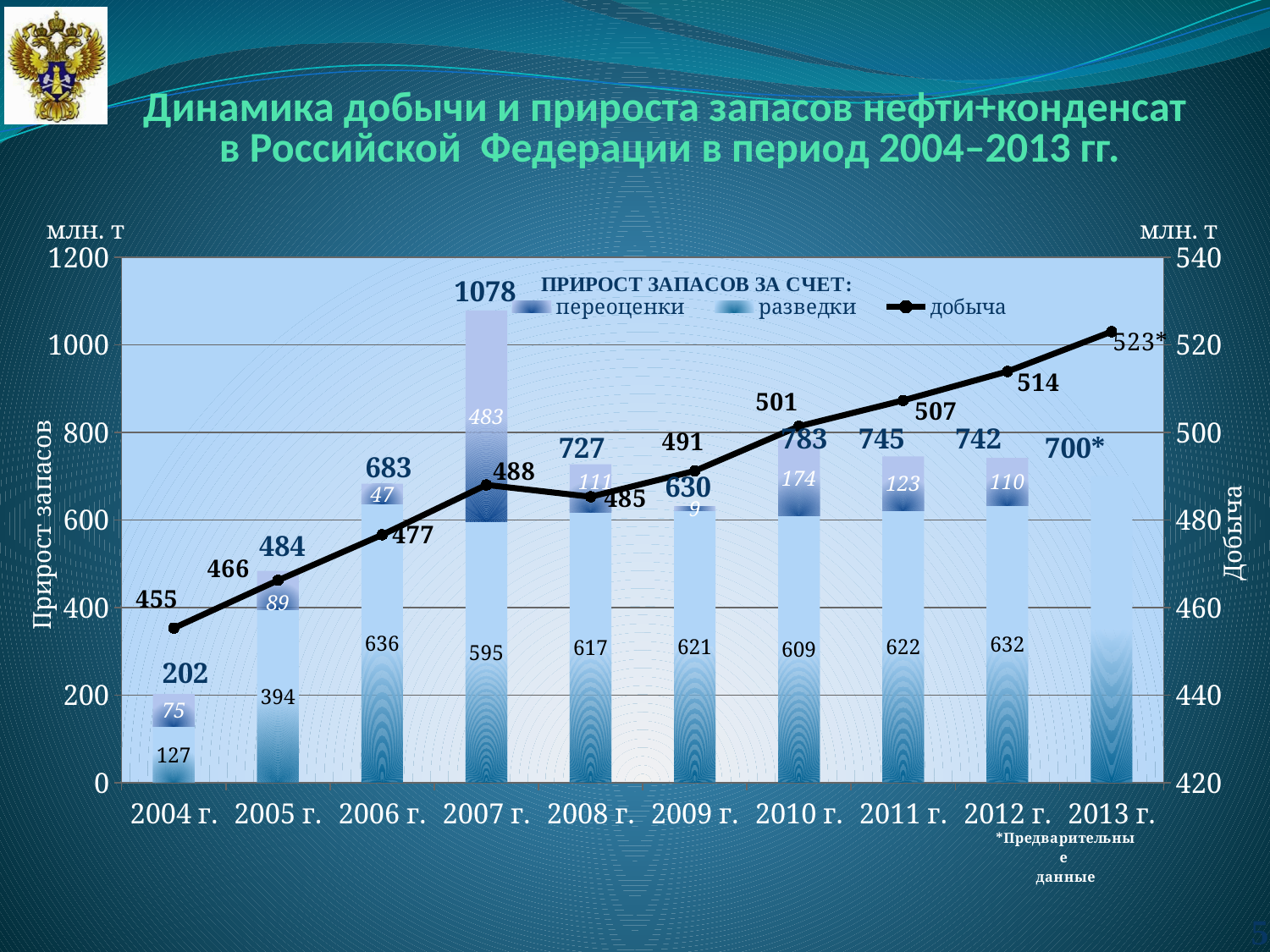
How many series does the chart legend list? 3 What is the разведки (exploration) component of the reserves growth bar for 2006 г.? 636 What kind of chart is shown on the slide? Combined stacked bar and line chart By how much did добыча (production) increase from 2004 г. (455) to 2013 г. (523*)? 68 In which year is the total прирост запасов (reserves growth) bar the lowest? 2004 г. What is the value of добыча (production) for 2010 г.? 501 Does the добыча (production) line generally rise or fall from 2004 г. to 2013 г.? Rise What is the total of the stacked bar for 2010 г. (разведки 609 plus переоценки 174)? 783 In which year is the total прирост запасов (reserves growth) bar the highest? 2007 г. What is the переоценки (revaluation) component of the reserves growth bar for 2007 г.? 483 How many years are shown on the x axis of the chart? 10 Which year has the larger total reserves growth bar, 2010 г. or 2011 г.? 2010 г.